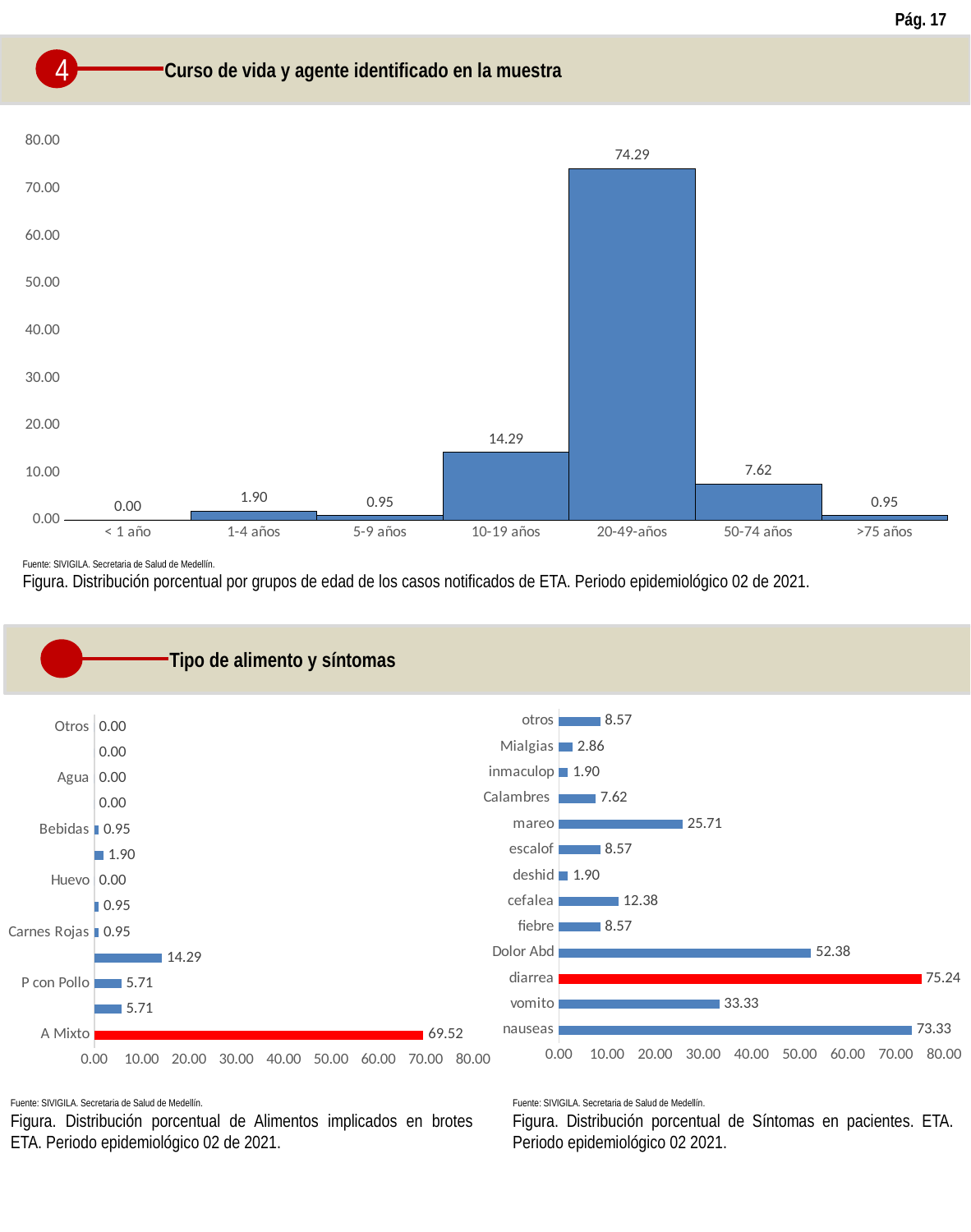
In the top chart (age groups), which age group has the highest value? 20-49-años In the top chart (age groups), what is the value for 1-4 años? 1.90 In the bottom-left chart (foods), what is the value for A Mixto? 69.52 In the bottom-right chart (symptoms), how many symptoms are listed? 13 In the bottom-right chart (symptoms), what is the value for diarrea? 75.24 In the bottom-right chart (symptoms), what is the difference between the values for nauseas and Dolor Abd? 20.95 What type of chart is the bottom-left chart (foods)? bar chart In the top chart (age groups), what is the difference between the values for 10-19 años and 50-74 años? 6.67 In the top chart (age groups), how many age groups are shown on the x axis? 7 In the bottom-right chart (symptoms), which symptom has the highest value? diarrea In the bottom-right chart (symptoms), which is larger, the value for vomito or the value for mareo? vomito In the top chart (age groups), what is the value for 20-49-años? 74.29